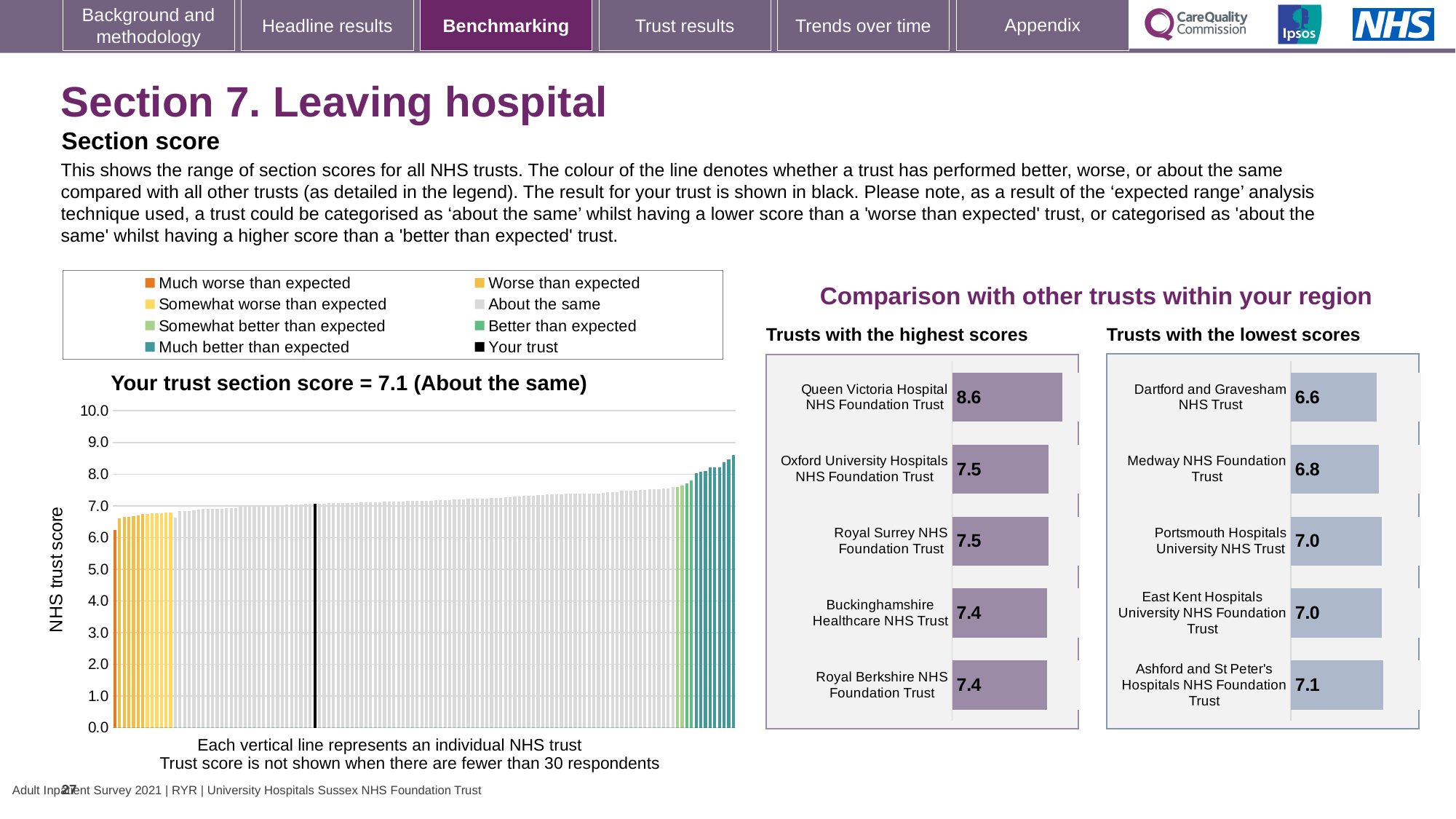
In the 'Trusts with the lowest scores' chart, which trust has the lowest score? Dartford and Gravesham NHS Trust How many trusts are shown in the 'Trusts with the highest scores' chart? 5 In the 'Trusts with the highest scores' chart, which trust has the highest score? Queen Victoria Hospital NHS Foundation Trust In the 'Trusts with the lowest scores' chart, what is the difference between the scores of Ashford and St Peter's Hospitals NHS Foundation Trust and Dartford and Gravesham NHS Trust? 0.5 In the main chart on the left, is the value of the tallest bar greater or less than 8.0? greater In the 'Trusts with the highest scores' chart, what is the difference between the scores of Queen Victoria Hospital NHS Foundation Trust and Royal Berkshire NHS Foundation Trust? 1.2 In the 'Trusts with the highest scores' chart, what is the score for Queen Victoria Hospital NHS Foundation Trust? 8.6 In the 'Trusts with the highest scores' chart, what is the score for Buckinghamshire Healthcare NHS Trust? 7.4 In the 'Trusts with the lowest scores' chart, which has the larger score: Dartford and Gravesham NHS Trust or Portsmouth Hospitals University NHS Trust? Portsmouth Hospitals University NHS Trust How many entries does the legend of the main chart on the left list? 8 In the 'Trusts with the lowest scores' chart, what is the score for Medway NHS Foundation Trust? 6.8 In the main chart on the left, what is your trust's section score? 7.1